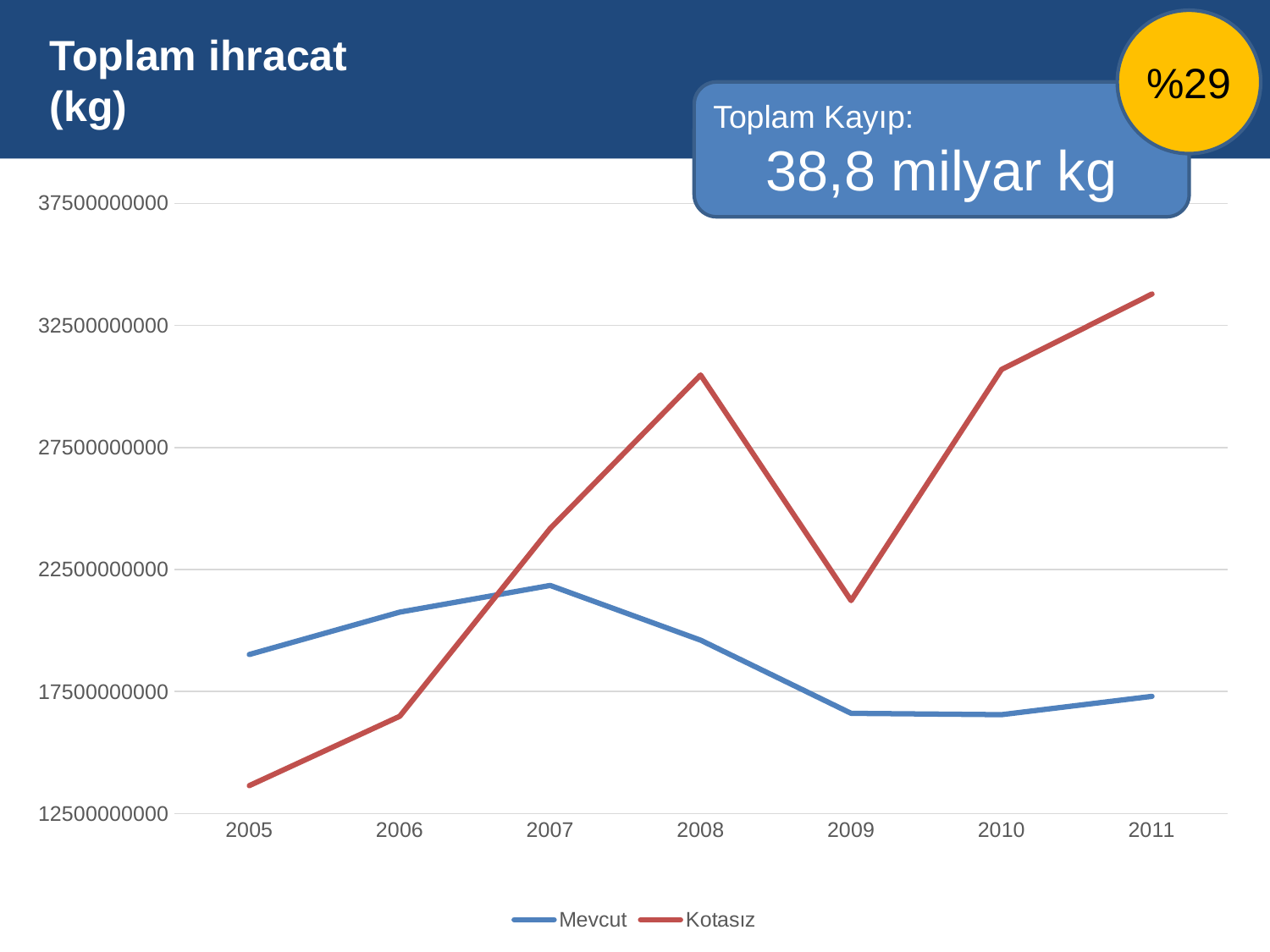
What kind of chart is shown on the slide? line chart In 2005, which series has the larger value, Mevcut or Kotasız? Mevcut In 2008, which series has the larger value, Mevcut or Kotasız? Kotasız How many years are shown on the x axis? 7 In which year is the Mevcut series at its highest? 2007 In which year is the Kotasız series at its lowest? 2005 What is the title of the chart? Toplam ihracat (kg) In which year is the Kotasız series at its highest? 2011 Is the value for Mevcut in 2009 greater or less than 17500000000? less Does the Mevcut series rise or fall from 2007 to 2010? fall Is the value for Kotasız in 2011 greater or less than 32500000000? greater How many series does the legend list? 2